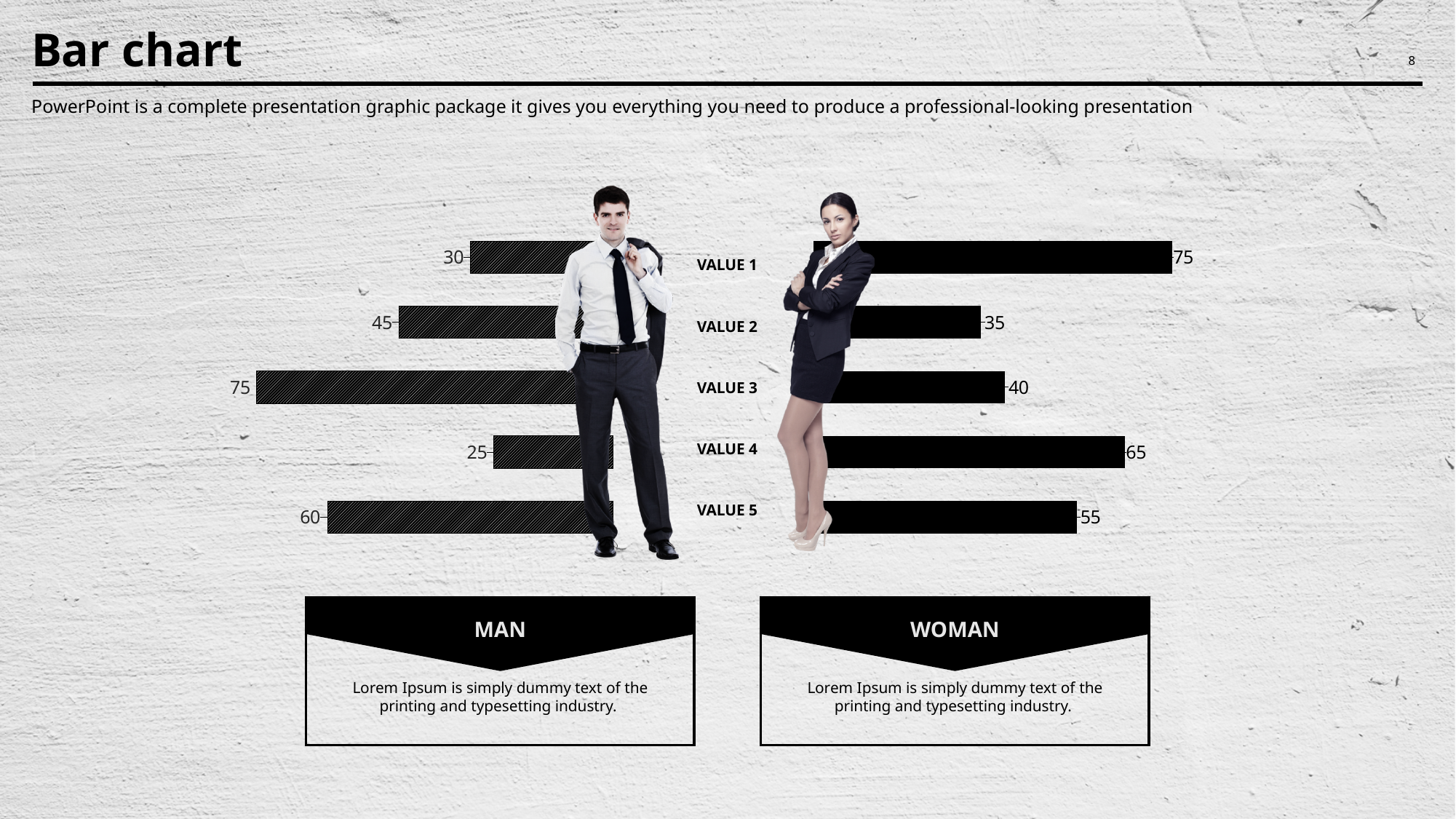
What is the MAN value for VALUE 3? 75 What is the WOMAN value for VALUE 5? 55 Which category has the lowest MAN value? VALUE 4 What is the WOMAN value for VALUE 1? 75 What are the two groups compared in the chart? MAN and WOMAN What is the MAN value for VALUE 4? 25 What kind of chart is shown on the slide? Bar chart What is the difference between the WOMAN value and the MAN value for VALUE 1? 45 How many categories are shown in the chart? 5 Which category has the lowest WOMAN value? VALUE 2 For VALUE 5, which is larger, the MAN value or the WOMAN value? MAN Which category has the highest MAN value? VALUE 3